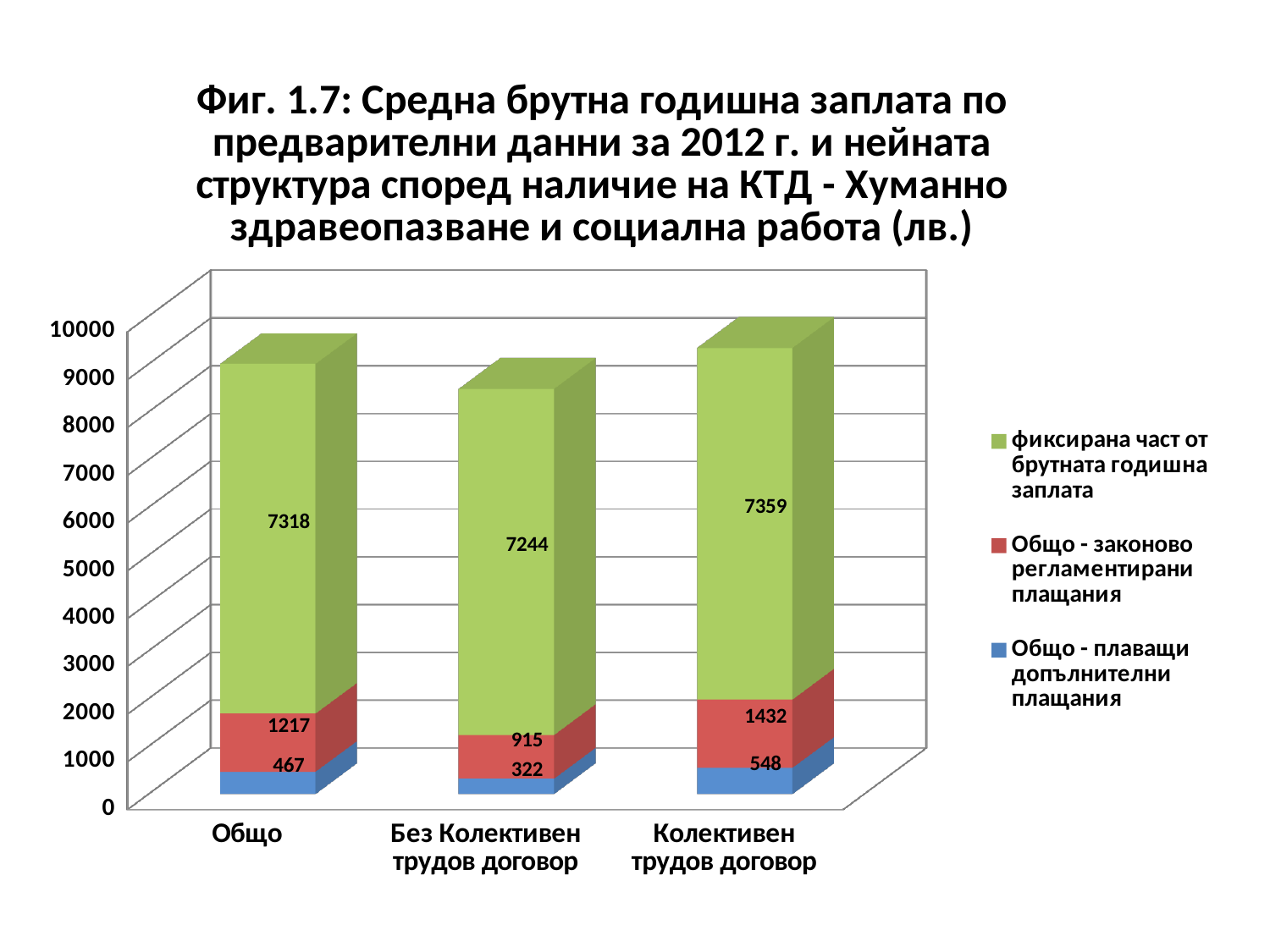
How many categories are shown on the x axis? 3 What is the total of the stacked bar for 'Без Колективен трудов договор'? 8481 Which category has the highest value for 'Общо - законово регламентирани плащания'? Колективен трудов договор What kind of chart is shown on the slide? stacked bar chart What is the difference between the 'Общо - законово регламентирани плащания' values for 'Колективен трудов договор' and 'Без Колективен трудов договор'? 517 How many series does the legend list? 3 What is the value of 'Общо - законово регламентирани плащания' for 'Без Колективен трудов договор'? 915 What is the total of the stacked bar for 'Колективен трудов договор'? 9339 Which category has the lowest value for 'Общо - плаващи допълнителни плащания'? Без Колективен трудов договор What is the value of 'фиксирана част от брутната годишна заплата' for 'Общо'? 7318 What is the value of 'Общо - плаващи допълнителни плащания' for 'Колективен трудов договор'? 548 Which is larger: the 'фиксирана част от брутната годишна заплата' value for 'Общо' or for 'Без Колективен трудов договор'? Общо